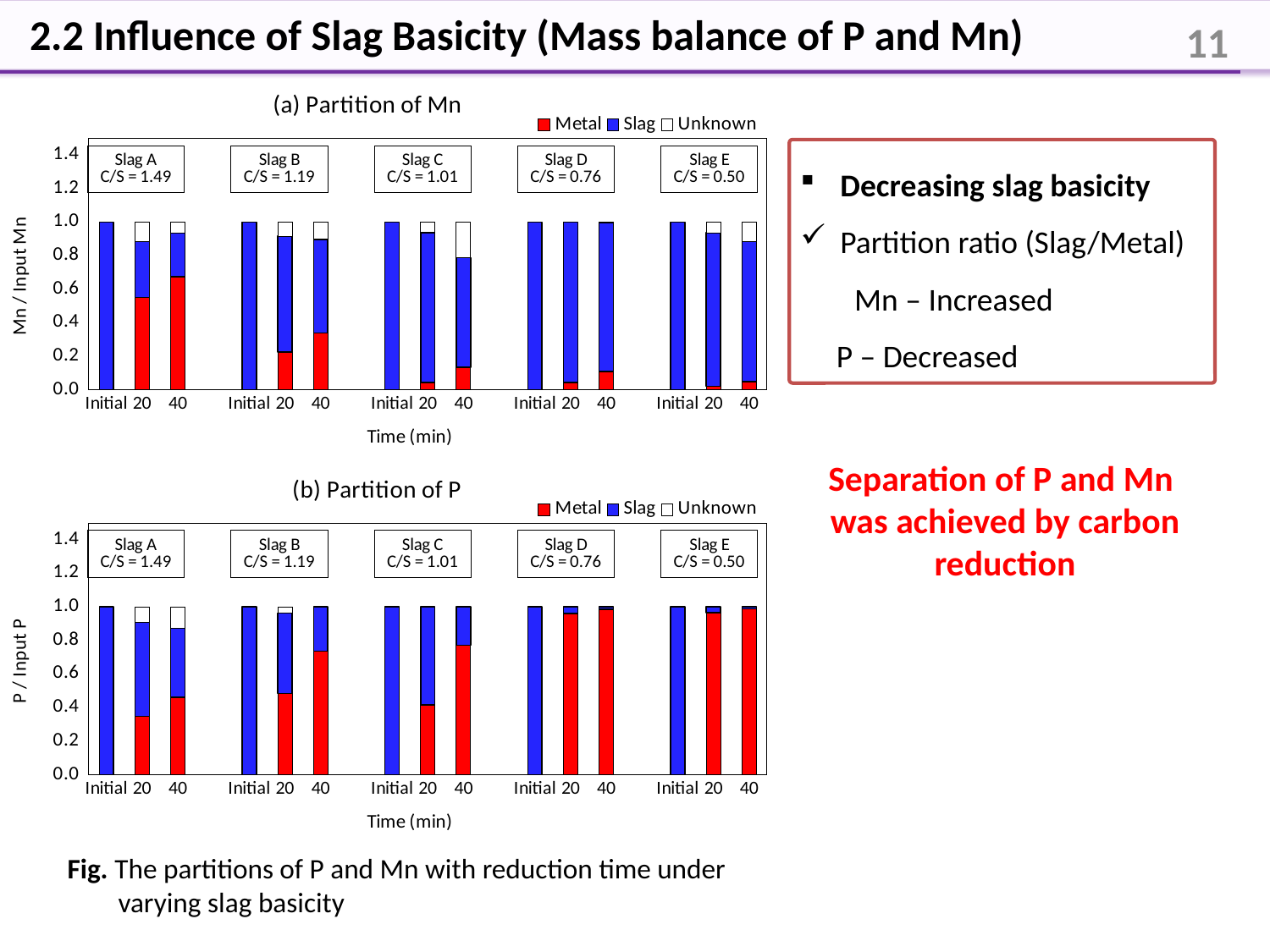
In '(b) Partition of P', does the Metal portion for Slag A rise or fall from Initial to 40 min? rise In '(a) Partition of Mn', at 40 min, is the Metal portion larger for Slag A or Slag D? Slag A What type of chart is '(a) Partition of Mn'? bar chart What are the legend entries in '(a) Partition of Mn'? Metal, Slag, Unknown In '(b) Partition of P', is the Metal portion for Slag D at 40 min greater or less than 0.8? greater What is the y-axis label of '(b) Partition of P'? P / Input P In '(a) Partition of Mn', is the Metal portion for Slag E at 40 min greater or less than 0.2? less In '(a) Partition of Mn', how many slag groups (Slag A to Slag E) are shown? 5 In '(a) Partition of Mn', is the Metal portion for Slag A at 40 min greater or less than 0.4? greater In '(a) Partition of Mn', what C/S value is given for Slag C? 1.01 In '(b) Partition of P', at 40 min, is the Metal portion larger for Slag A or Slag E? Slag E How many series does the legend of '(b) Partition of P' list? 3